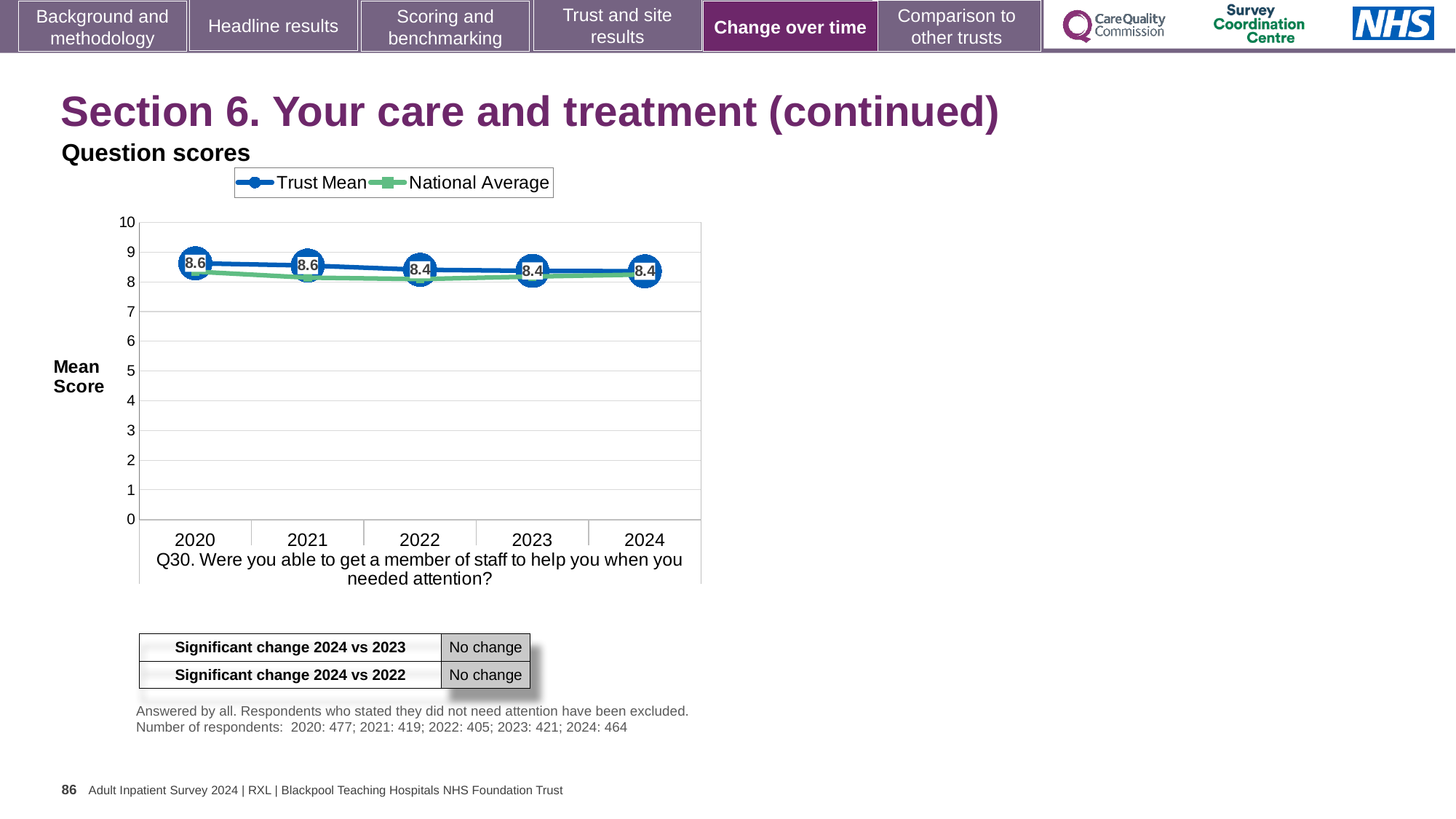
How many series does the chart legend list? 2 What is the Trust Mean score for Q30 in 2020? 8.6 What kind of chart is shown on the slide? line chart What is the difference between the Trust Mean score in 2020 and in 2024? 0.2 Does the Trust Mean score rise or fall from 2020 to 2024? fall What is the label of the y axis of the chart? Mean Score In 2020, which is higher: the Trust Mean or the National Average? Trust Mean What is the Trust Mean score for Q30 in 2021? 8.6 What is the Trust Mean score for Q30 in 2022? 8.4 What is the Trust Mean score for Q30 in 2024? 8.4 Is the National Average value for 2022 greater or less than 7? greater How many years are shown on the x axis of the chart? 5